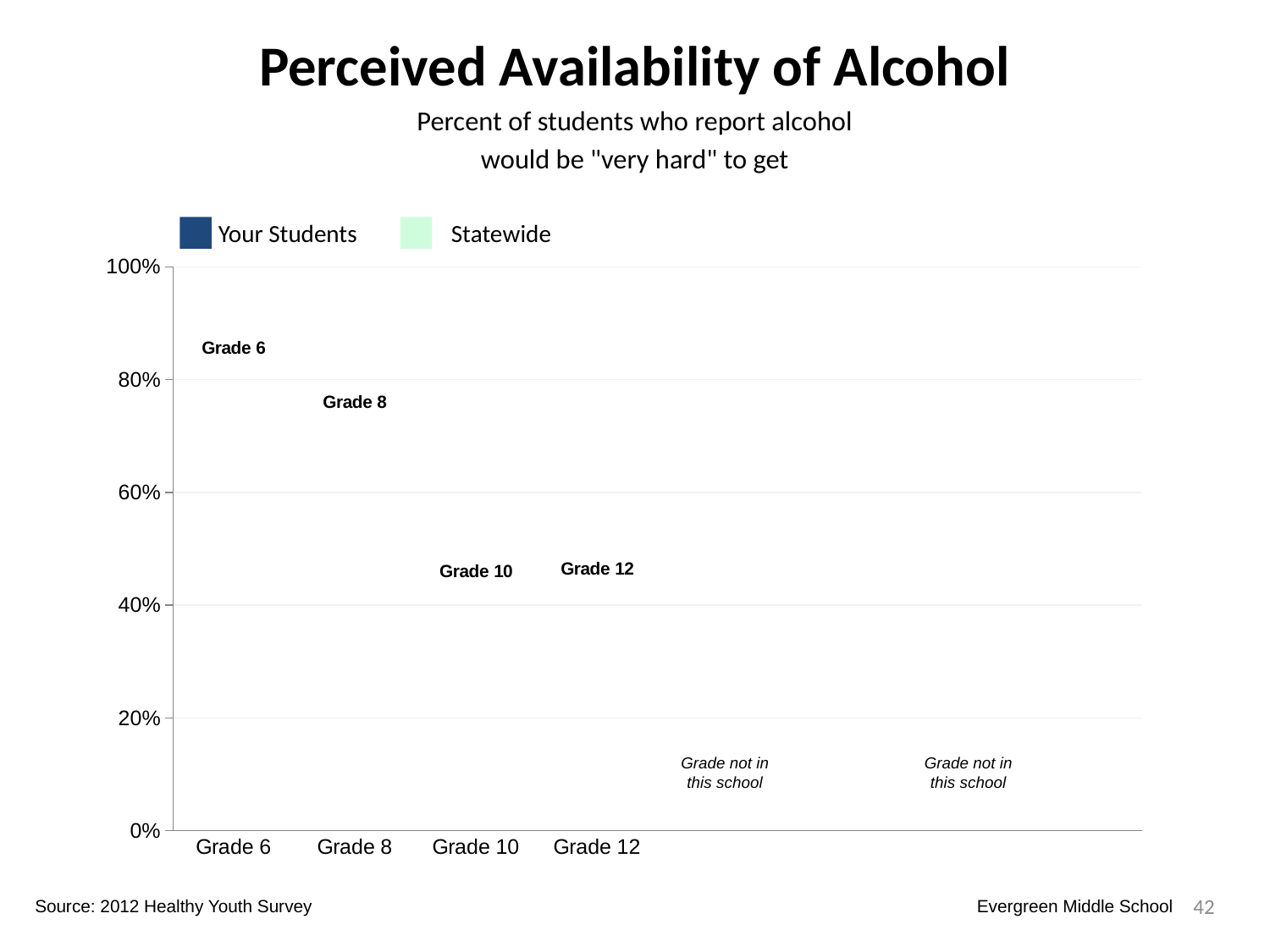
What is the highest value shown on the y axis? 100% How many grade categories are labelled on the x axis? 4 What are the two series named in the legend? Your Students and Statewide What is the interval between tick marks on the y axis? 20% Which grade categories are labelled on the x axis? Grade 6, Grade 8, Grade 10, Grade 12 How many series does the legend list? 2 What is the title of the chart? Perceived Availability of Alcohol